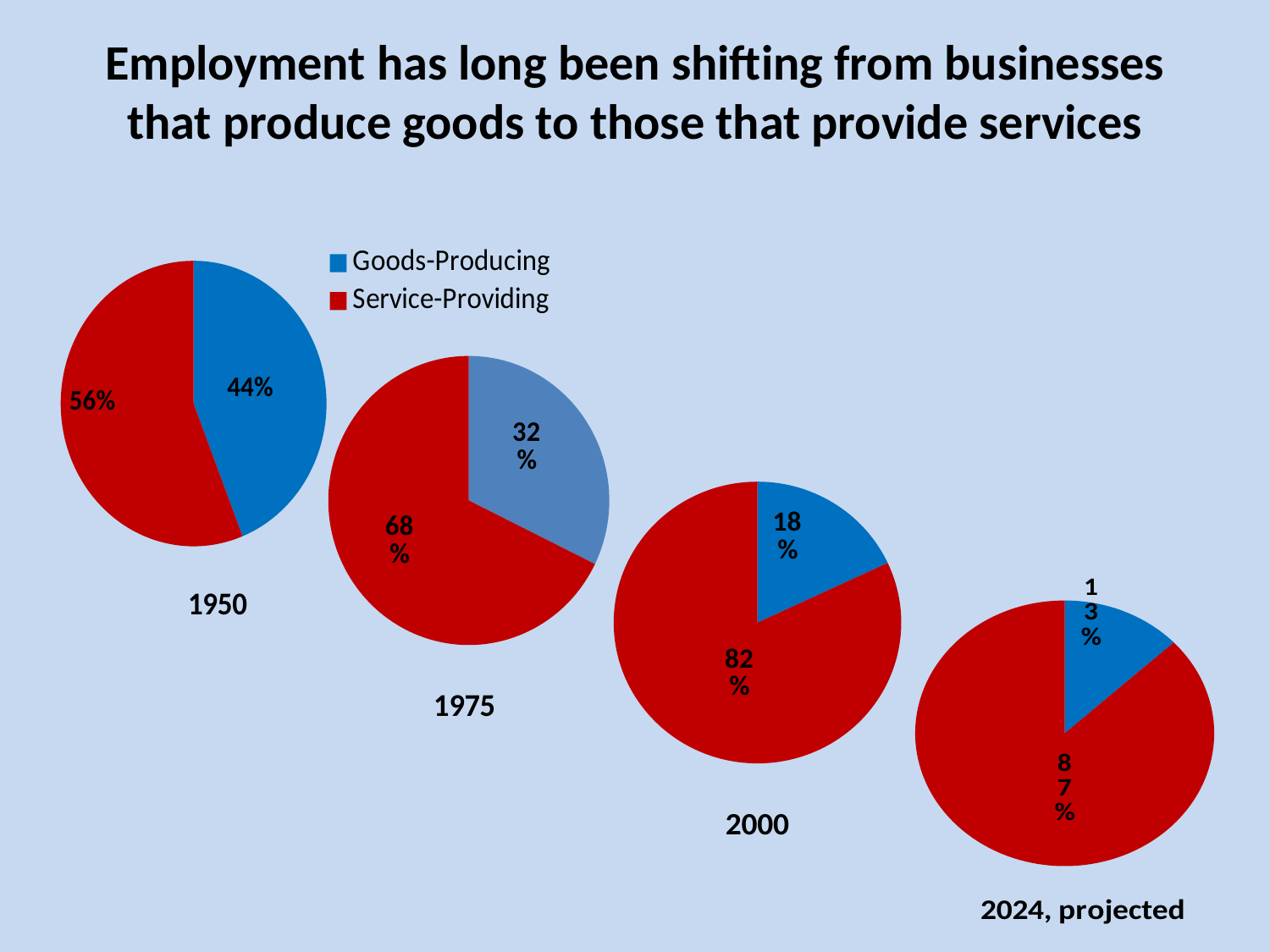
In the 2000 pie chart, which slice is larger, Goods-Producing or Service-Providing? Service-Providing In the 2024, projected pie chart, what share of employment is Service-Providing? 87% What kind of chart is used to show the 1950 employment split? Pie chart In the 1975 pie chart, what share of employment is Goods-Producing? 32% How many series does the legend list? 2 In the 1975 pie chart, what is the difference between the Service-Providing and Goods-Producing shares? 36% In the 2000 pie chart, what share of employment is Service-Providing? 82% How many pie charts are shown on the slide? 4 Across the pie charts from 1950 to 2024, does the Goods-Producing share rise or fall? Fall In the 2024, projected pie chart, what share of employment is Goods-Producing? 13% In the 1950 pie chart, what share of employment is Goods-Producing? 44% In the 1950 pie chart, what share of employment is Service-Providing? 56%